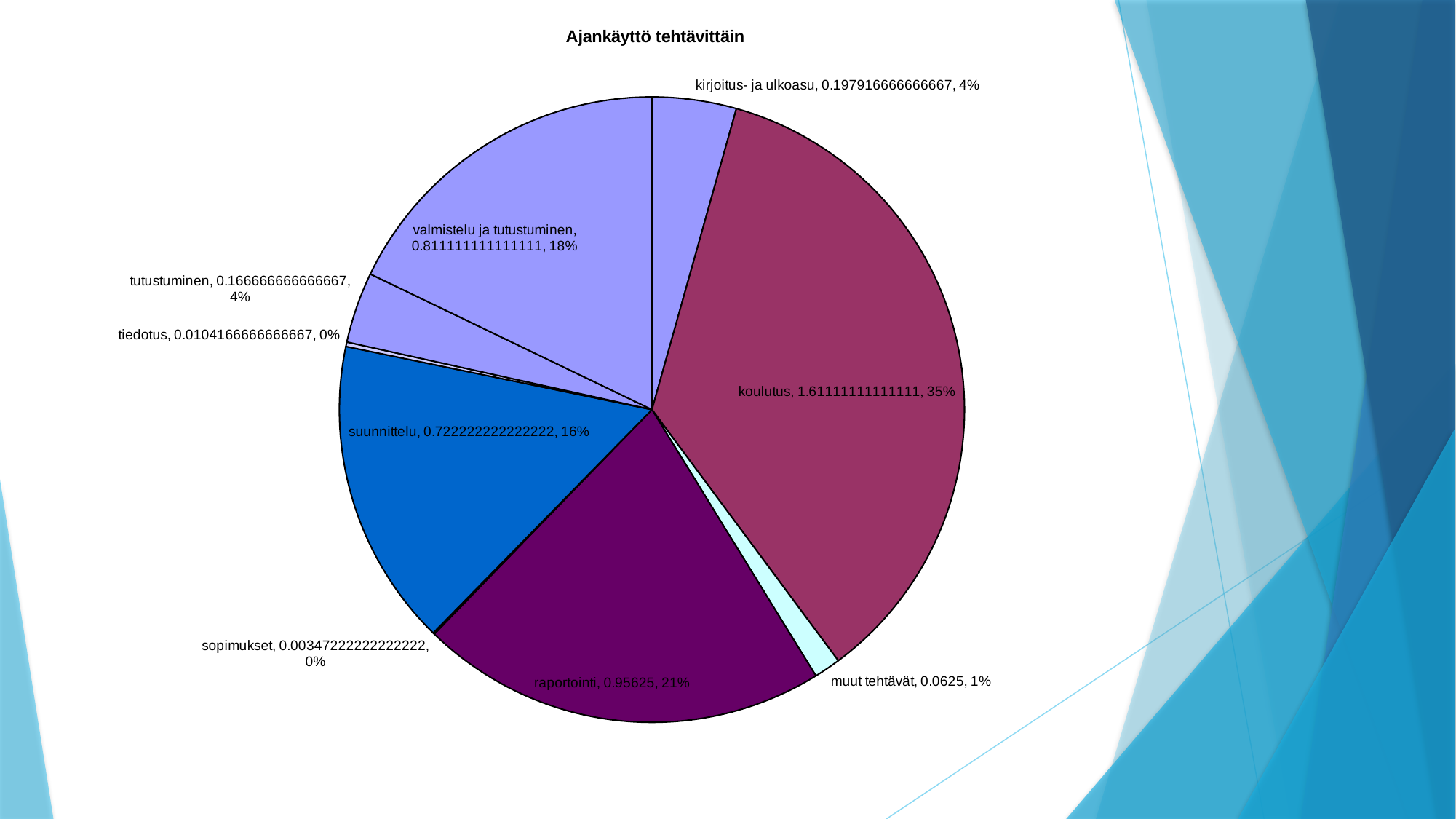
Which is larger, the slice for raportointi or the slice for suunnittelu? raportointi Which category has the largest slice of the pie? koulutus What is the value shown for muut tehtävät? 0.0625 What kind of chart is shown on the slide? pie chart What is the title of the chart? Ajankäyttö tehtävittäin What is the value shown for tiedotus? 0.0104166666666667 How many slices does the pie chart have? 9 What share of the pie does valmistelu ja tutustuminen take? 18% What share of the pie does koulutus take? 35% What share of the pie does suunnittelu take? 16% Which category has the smallest slice of the pie? sopimukset What is the value shown for raportointi? 0.95625